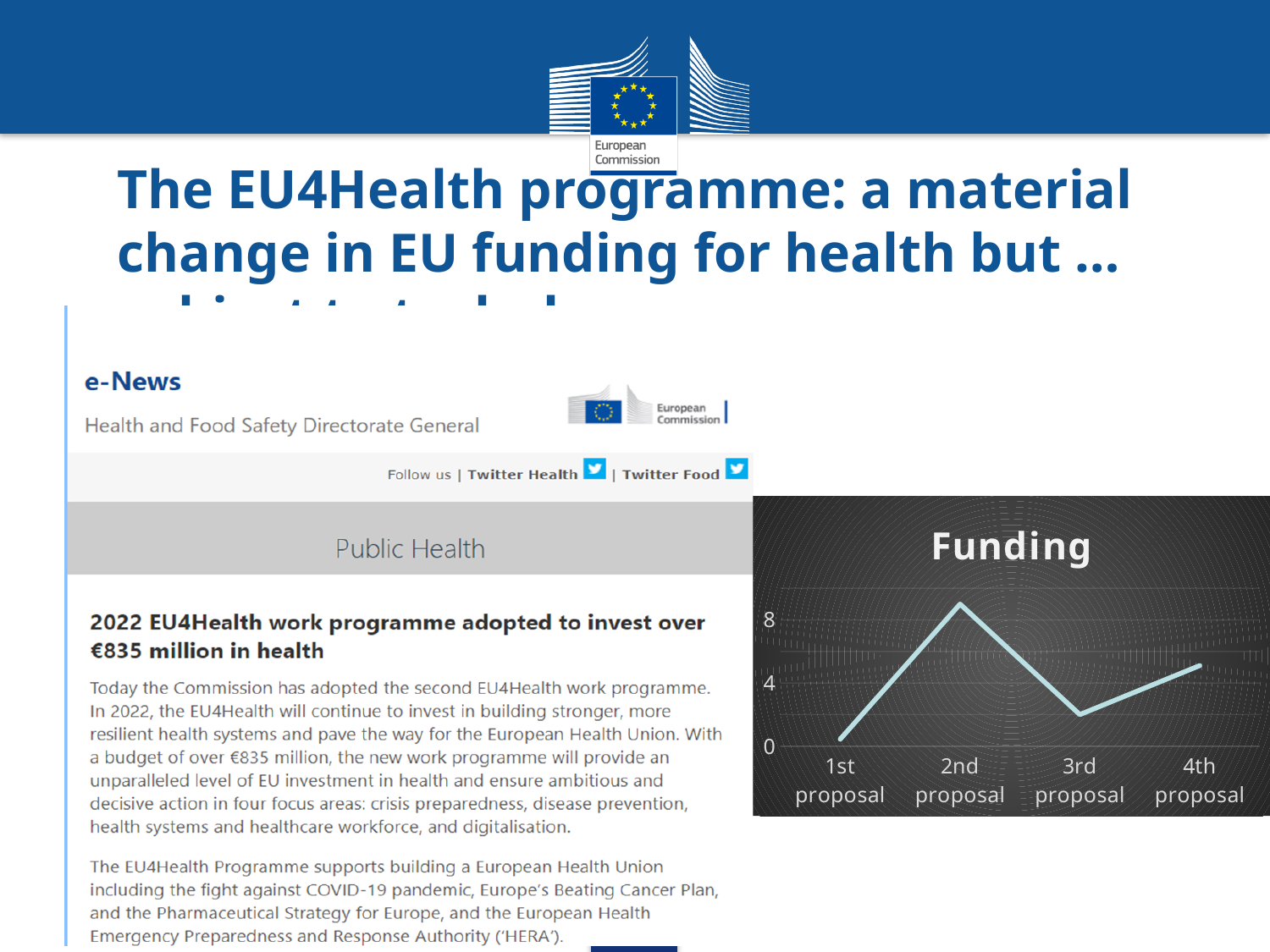
In the 'Funding' chart, is the value for the 4th proposal greater or less than 4? greater Which proposal has the highest value in the 'Funding' chart? 2nd proposal In the 'Funding' chart, which is larger: the value for the 2nd proposal or the 4th proposal? 2nd proposal What is the title of the chart on the slide? Funding In the 'Funding' chart, is the value for the 3rd proposal greater or less than 4? less In the 'Funding' chart, is the value for the 1st proposal greater or less than 4? less Which proposal has the lowest value in the 'Funding' chart? 1st proposal How many proposals are plotted on the x axis of the 'Funding' chart? 4 In the 'Funding' chart, which is larger: the value for the 4th proposal or the 3rd proposal? 4th proposal What kind of chart is the 'Funding' chart? line chart In the 'Funding' chart, does the value rise or fall from the 2nd proposal to the 3rd proposal? fall